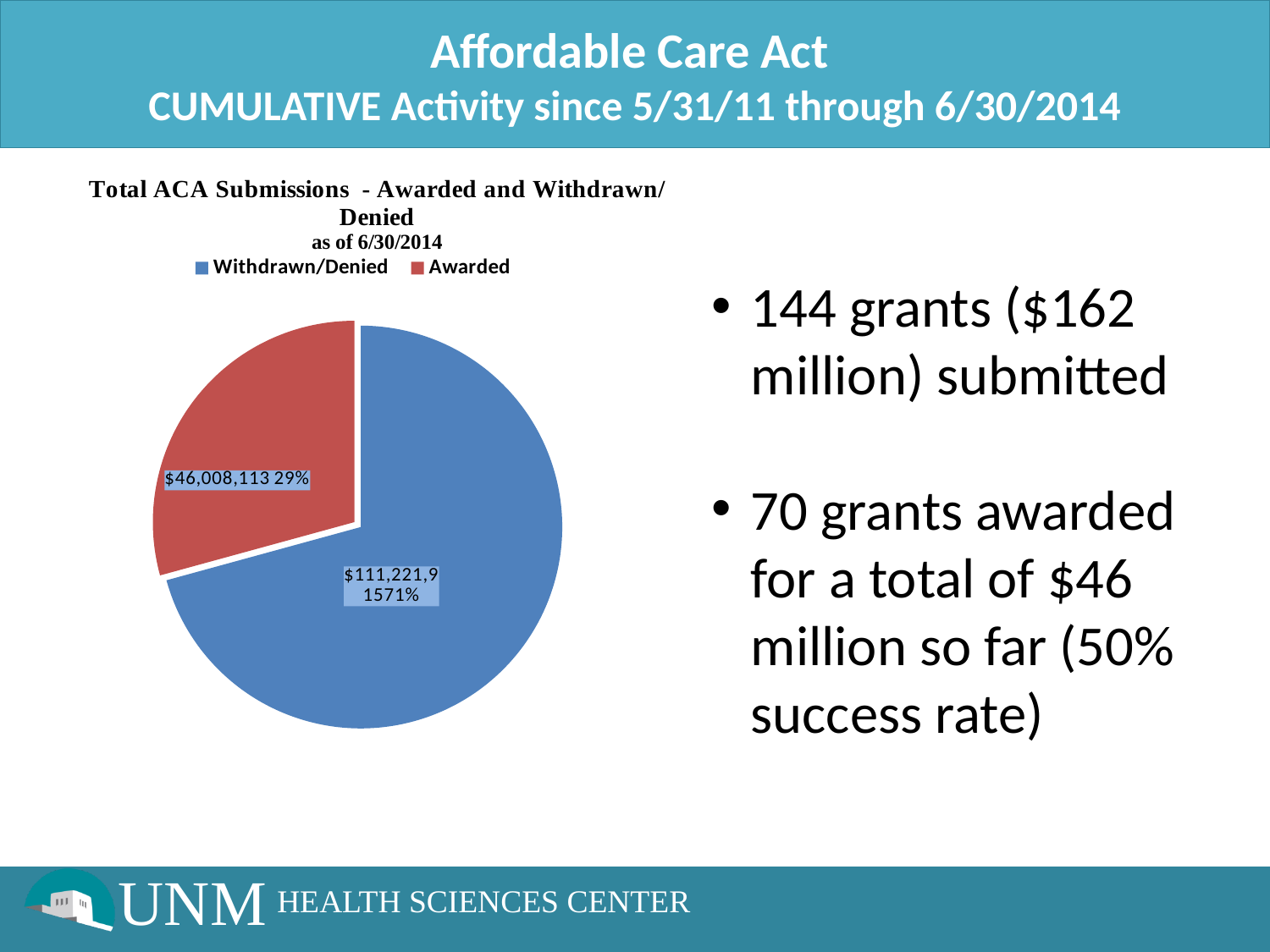
Which category has the largest slice of the pie? Withdrawn/Denied Which is larger, the Withdrawn/Denied slice or the Awarded slice? Withdrawn/Denied What share of the pie does the Withdrawn/Denied slice represent? 71% What colour is the Awarded slice in the pie chart? Red What is the dollar value shown for the Awarded slice? $46,008,113 How many slices does the pie chart have? 2 What share of the pie does the Awarded slice represent? 29% What is the title of the pie chart? Total ACA Submissions - Awarded and Withdrawn/Denied as of 6/30/2014 What kind of chart is shown on the slide? Pie chart How many categories does the pie chart legend list? 2 Which category has the smallest slice of the pie? Awarded